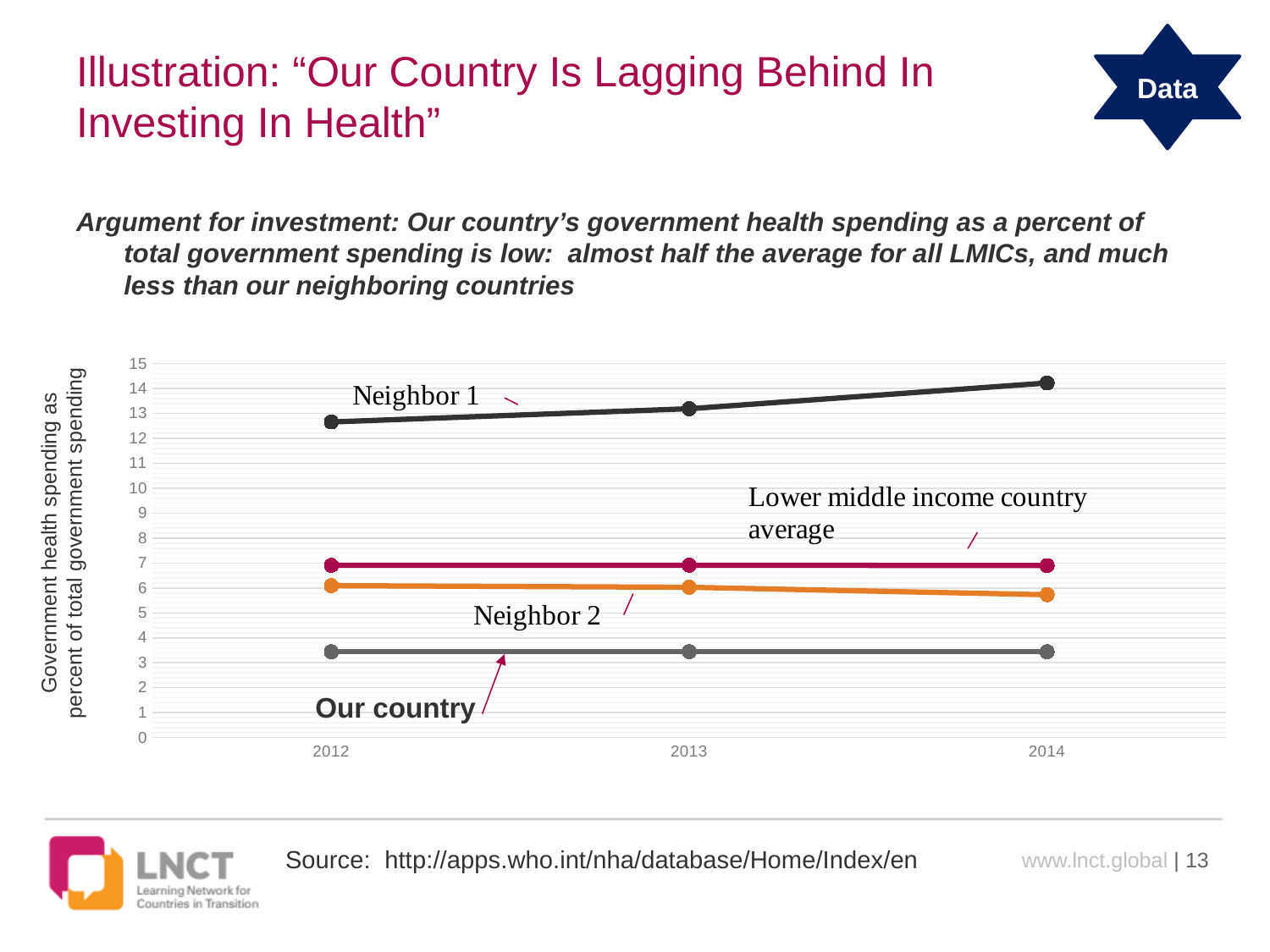
In 2012, which is larger: Neighbor 2 or the Lower middle income country average? Lower middle income country average Which series has the highest value in 2014? Neighbor 1 How many years are shown on the x axis of the chart? 3 Is the Lower middle income country average in 2013 greater or less than 6? greater Does the Neighbor 1 line rise or fall from 2012 to 2014? Rises Which series has the lowest value in 2012? Our country Is the value for Neighbor 2 in 2014 greater or less than 7? less How many lines (series) are plotted on the chart? 4 Is the value for Neighbor 1 in 2014 greater or less than 13? greater What kind of chart is shown on the slide? Line chart What is the label on the y axis of the chart? Government health spending as percent of total government spending